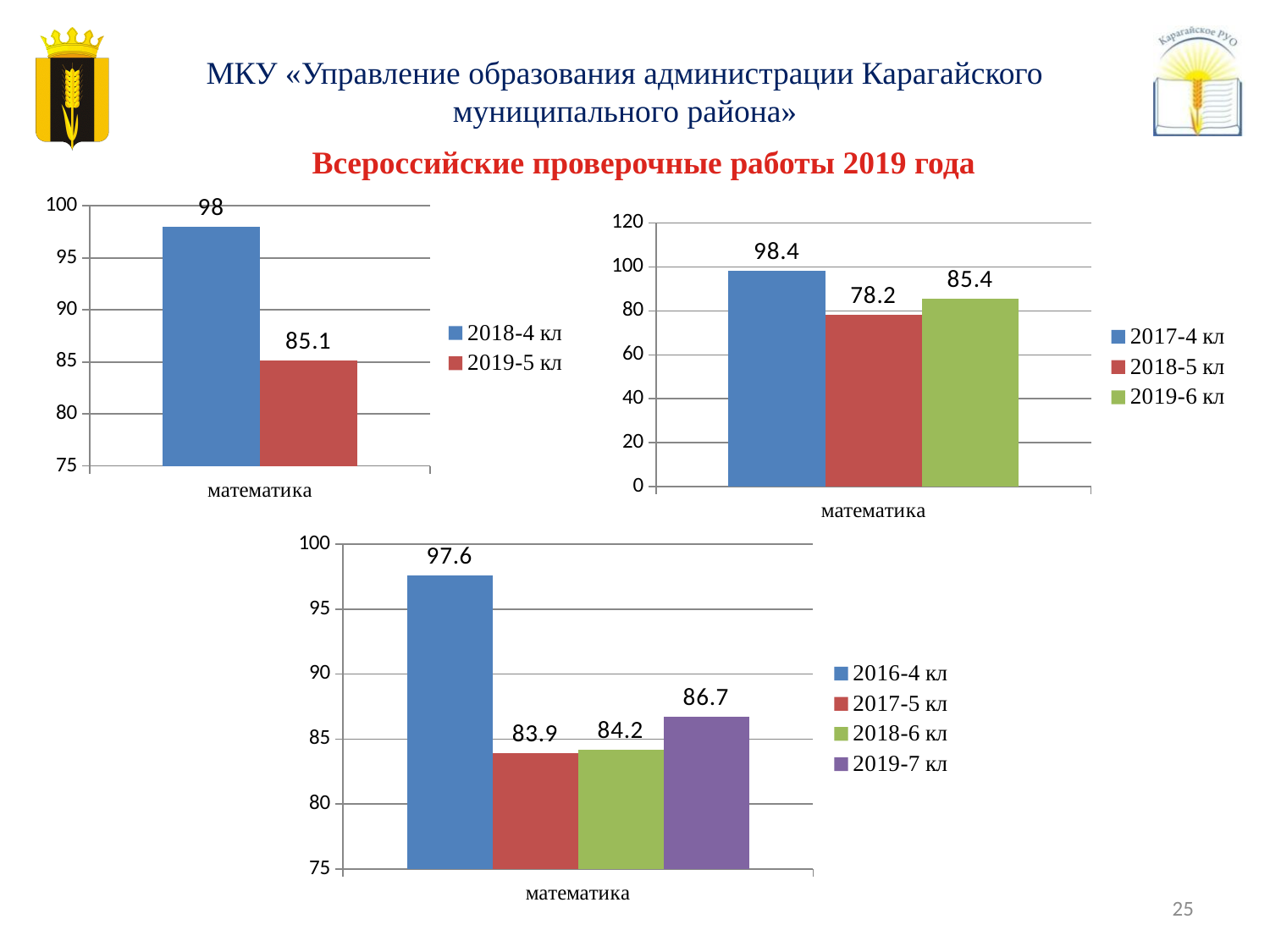
In the top-left chart, what is the value for 2018-4 кл? 98 In the top-right chart, what is the value for 2018-5 кл? 78.2 What kind of chart is the bottom chart? Bar chart In the top-right chart, how many series does the legend list? 3 In the bottom chart, what is the difference between the 2016-4 кл and 2019-7 кл values? 10.9 In the top-right chart, which series has the lowest value? 2018-5 кл In the bottom chart, what is the value for 2019-7 кл? 86.7 In the top-right chart, which series has the highest value? 2017-4 кл In the top-left chart, what is the difference between the 2018-4 кл and 2019-5 кл values? 12.9 In the top-left chart, what is the value for 2019-5 кл? 85.1 In the bottom chart, which is larger, the value for 2017-5 кл or 2018-6 кл? 2018-6 кл In the bottom chart, how many series does the legend list? 4